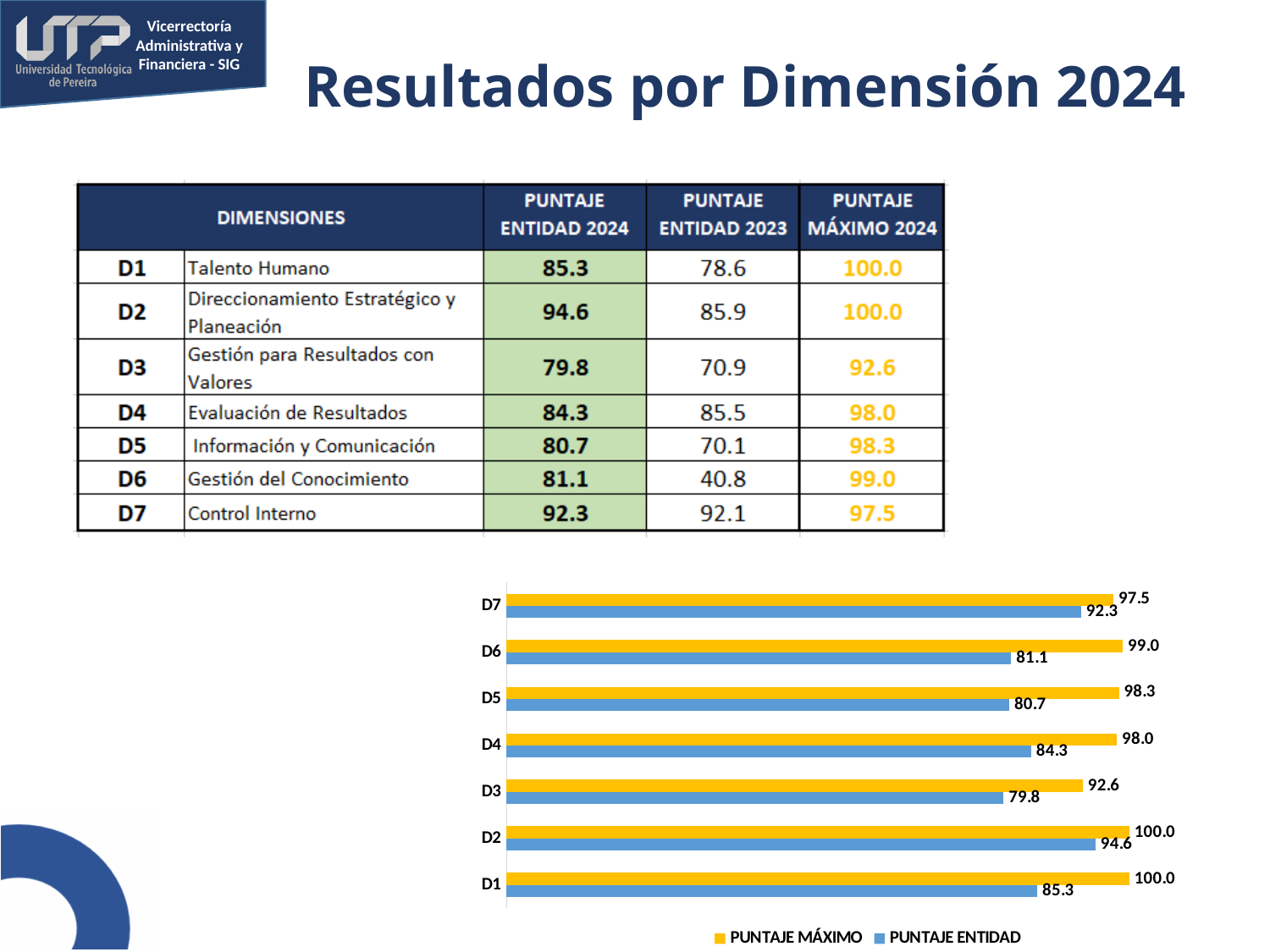
Which dimension has the highest PUNTAJE ENTIDAD in the chart? D2 Which colour represents PUNTAJE MÁXIMO in the chart? yellow What is the PUNTAJE MÁXIMO value for D3 in the chart? 92.6 What is the PUNTAJE ENTIDAD value for D5 in the chart? 80.7 What kind of chart is shown on the slide? bar chart Which dimension has the lowest PUNTAJE ENTIDAD in the chart? D3 How many dimensions (categories) are plotted in the chart? 7 How many series does the chart legend list? 2 Which is larger in the chart: the PUNTAJE ENTIDAD for D4 or for D1? D1 Which dimension has the lowest PUNTAJE MÁXIMO in the chart? D3 What is the PUNTAJE ENTIDAD value for D7 in the chart? 92.3 What is the difference between PUNTAJE MÁXIMO and PUNTAJE ENTIDAD for D6 in the chart? 17.9